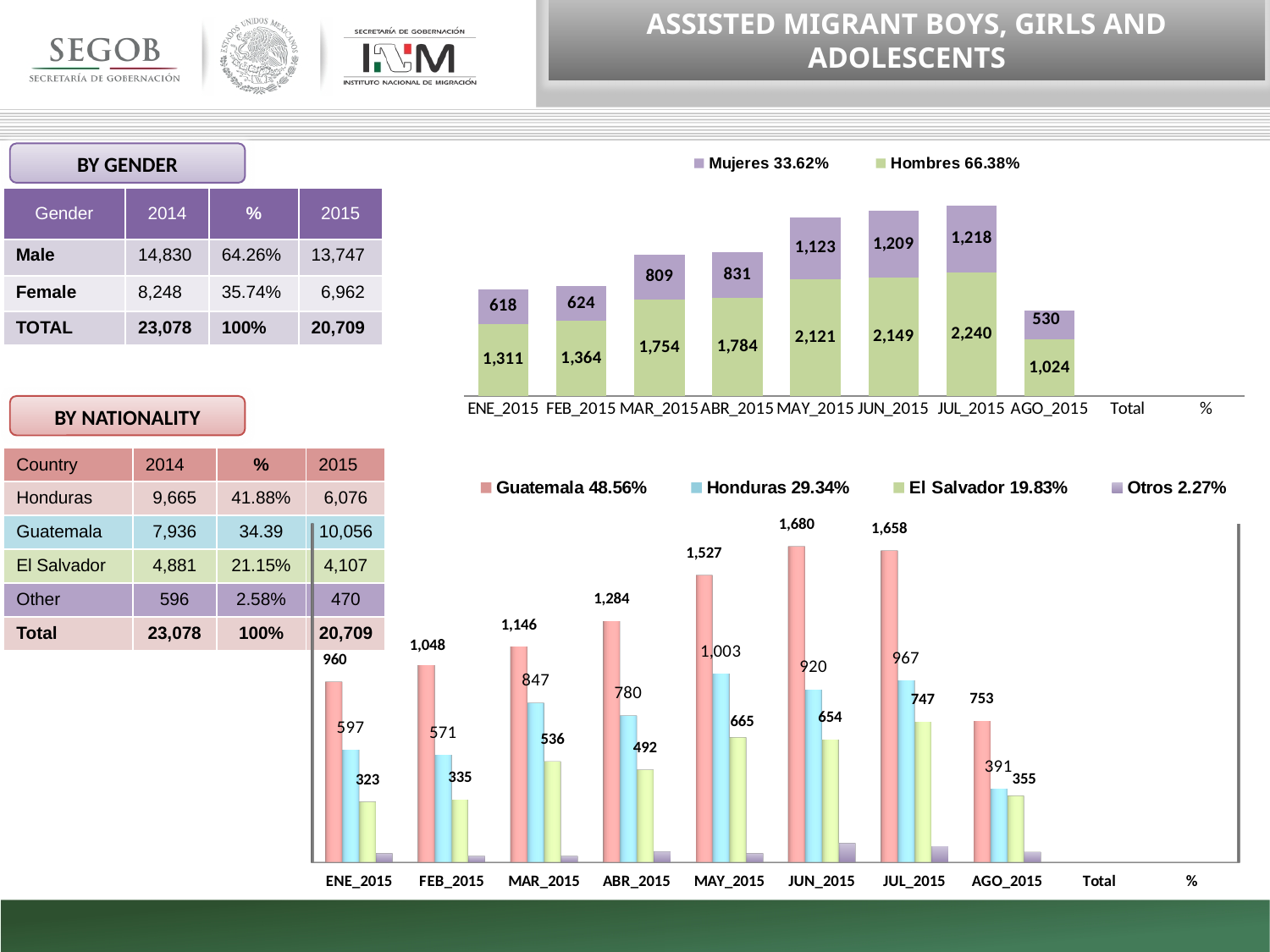
In the top stacked bar chart, which month has the lowest Mujeres value? AGO_2015 How many series does the legend of the bottom chart by nationality list? 4 In the top stacked bar chart, what is the Mujeres value for MAY_2015? 1,123 In the top stacked bar chart, which month has the highest Hombres value? JUL_2015 What kind of chart is the top chart showing Mujeres and Hombres? Stacked bar chart In the bottom chart by nationality, what is the Guatemala value for JUN_2015? 1,680 In the bottom chart by nationality, what is the Honduras value for MAR_2015? 847 In the bottom chart by nationality, what is the difference between the Guatemala and Honduras values for MAY_2015? 524 In the bottom chart by nationality, is the El Salvador value larger in JUL_2015 or in ABR_2015? JUL_2015 How many series does the legend of the top chart list? 2 In the top stacked bar chart, what is the total of the ENE_2015 bar (Mujeres plus Hombres)? 1,929 In the top stacked bar chart, what is the Hombres value for JUL_2015? 2,240